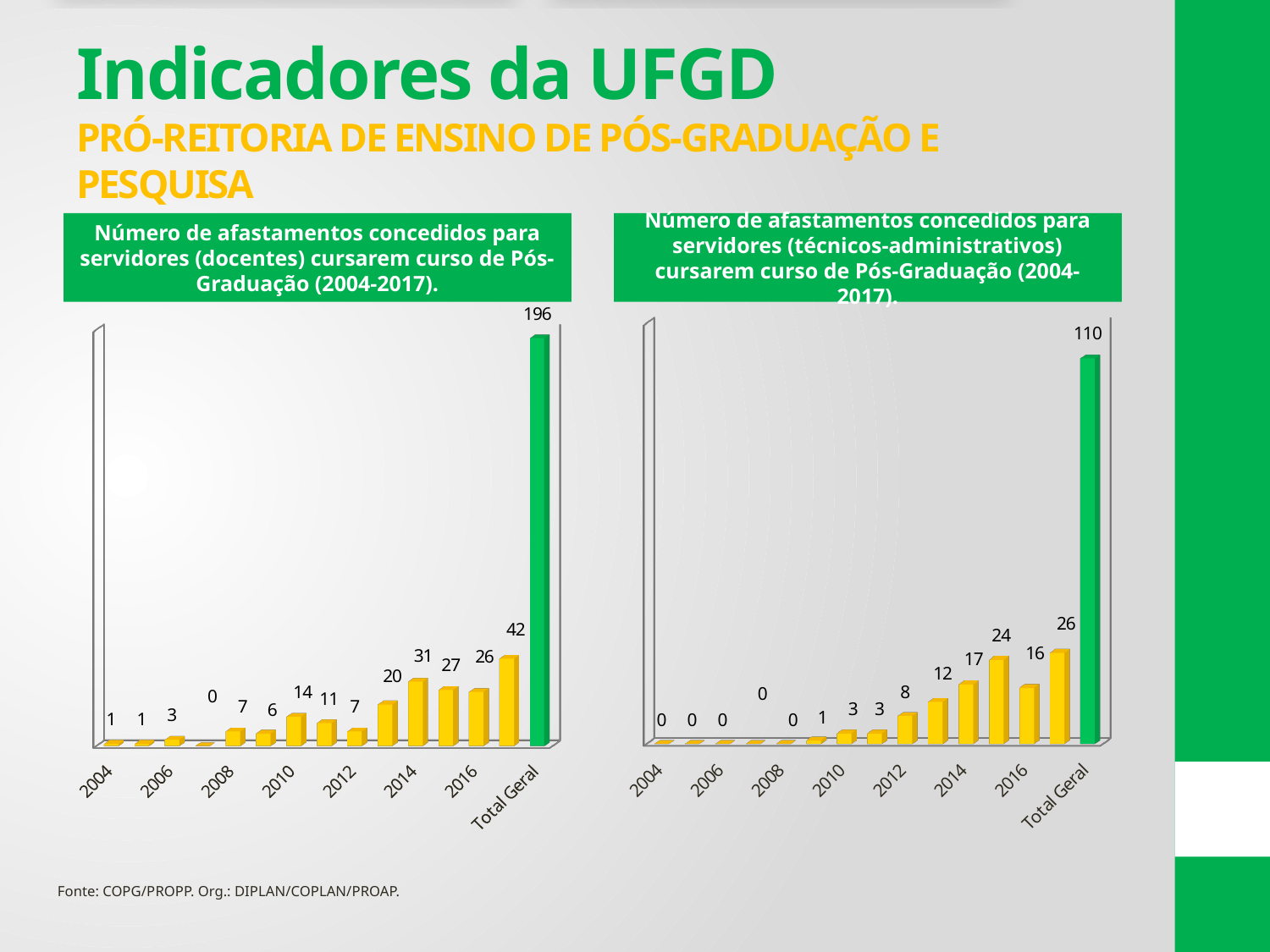
In the right chart (técnicos-administrativos), what is the value for 2016? 16 In the right chart (técnicos-administrativos), which is larger, the value for 2014 or the value for 2016? 2014 In the right chart (técnicos-administrativos), what is the value for 2012? 8 In the left chart (docentes), what is the value for 2014? 31 In the left chart (docentes), what is the value for Total Geral? 196 In the left chart (docentes), what is the difference between the values for 2016 and 2014? 5 In the left chart (docentes), which year between 2004 and 2016 has the lowest value? 2007 What is the source cited at the bottom of the slide? COPG/PROPP. Org.: DIPLAN/COPLAN/PROAP. In the left chart (docentes), what is the value for 2010? 14 How many bars are plotted in the right chart (técnicos-administrativos), including Total Geral? 15 What kind of chart is the left chart (docentes)? Bar chart In the right chart (técnicos-administrativos), what is the value for Total Geral? 110